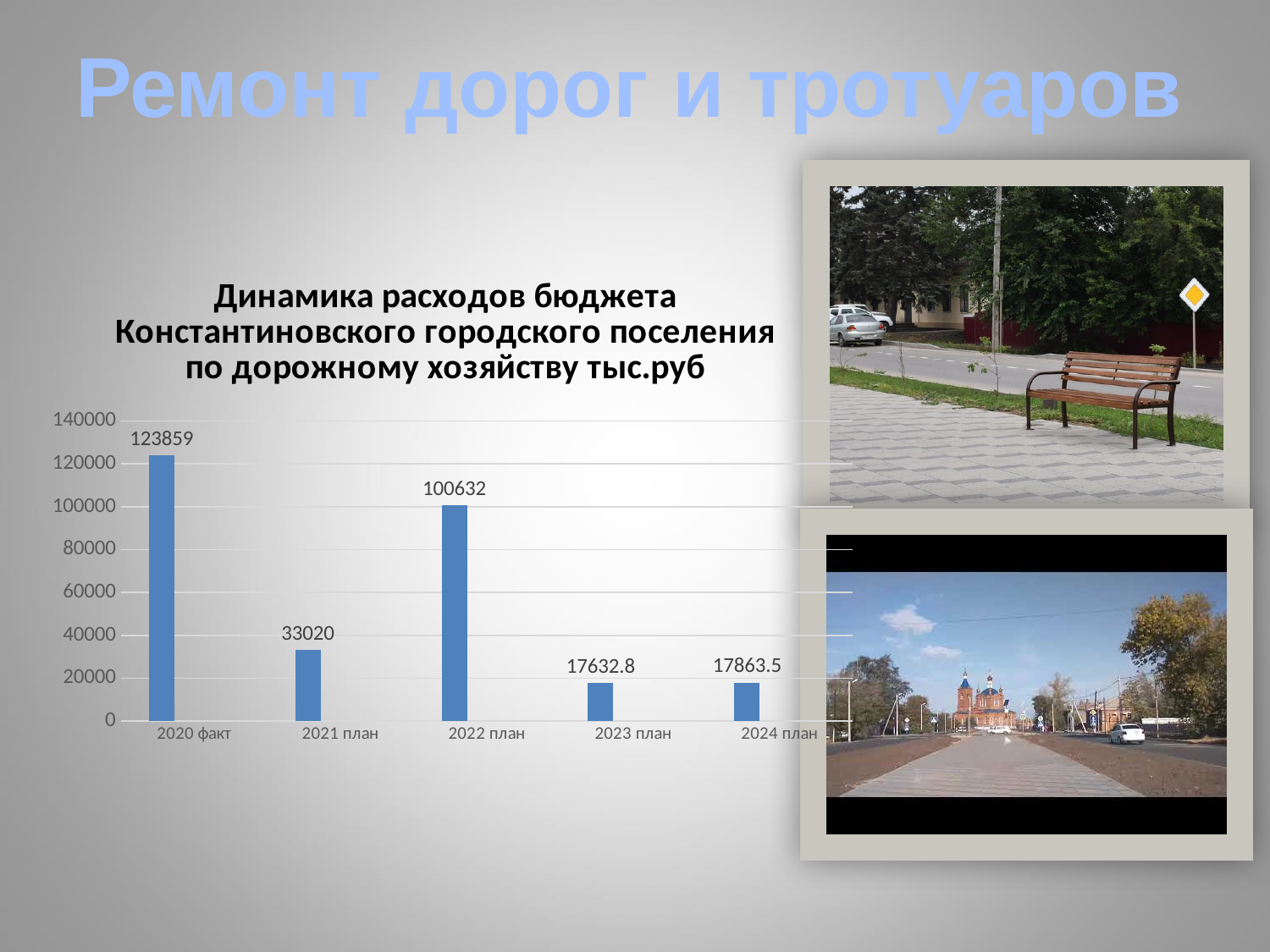
Which is larger, the value for 2021 план or the value for 2022 план? 2022 план How many categories are shown on the x axis? 5 What is the value for 2023 план? 17632.8 What kind of chart is shown on the slide? bar chart Which category has the highest value? 2020 факт What is the value for 2022 план? 100632 What is the difference between the values for 2020 факт and 2022 план? 23227 What is the value for 2020 факт? 123859 Is the value for 2021 план greater or less than 40000? less What is the value for 2024 план? 17863.5 Which category has the lowest value? 2023 план What is the difference between the values for 2021 план and 2023 план? 15387.2